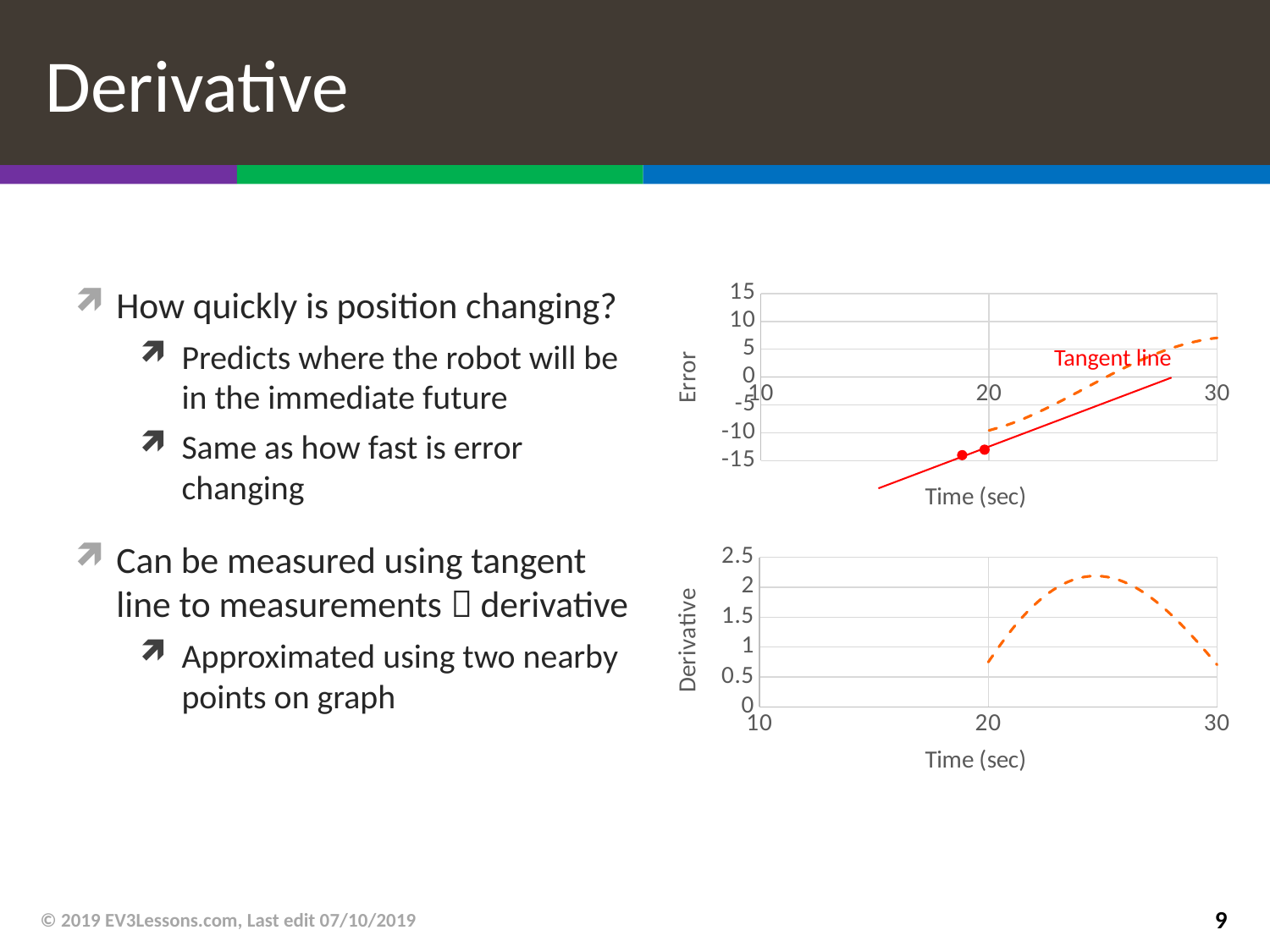
How many charts are shown on the slide? 2 In the top chart, is the error value at time 30 greater or less than 5? greater What kind of chart is the bottom chart on the slide? line chart In the top chart, what is the label of the vertical axis? Error In the bottom chart, what is the label of the horizontal axis? Time (sec) In the bottom chart, is the derivative value at time 20 greater or less than 0.5? greater In the bottom chart, is the highest derivative value greater or less than 2? greater What kind of chart is the top chart on the slide? line chart In the bottom chart, does the derivative rise or fall as time goes from 25 to 30? fall In the top chart, does the error rise or fall as time goes from 20 to 30? rise